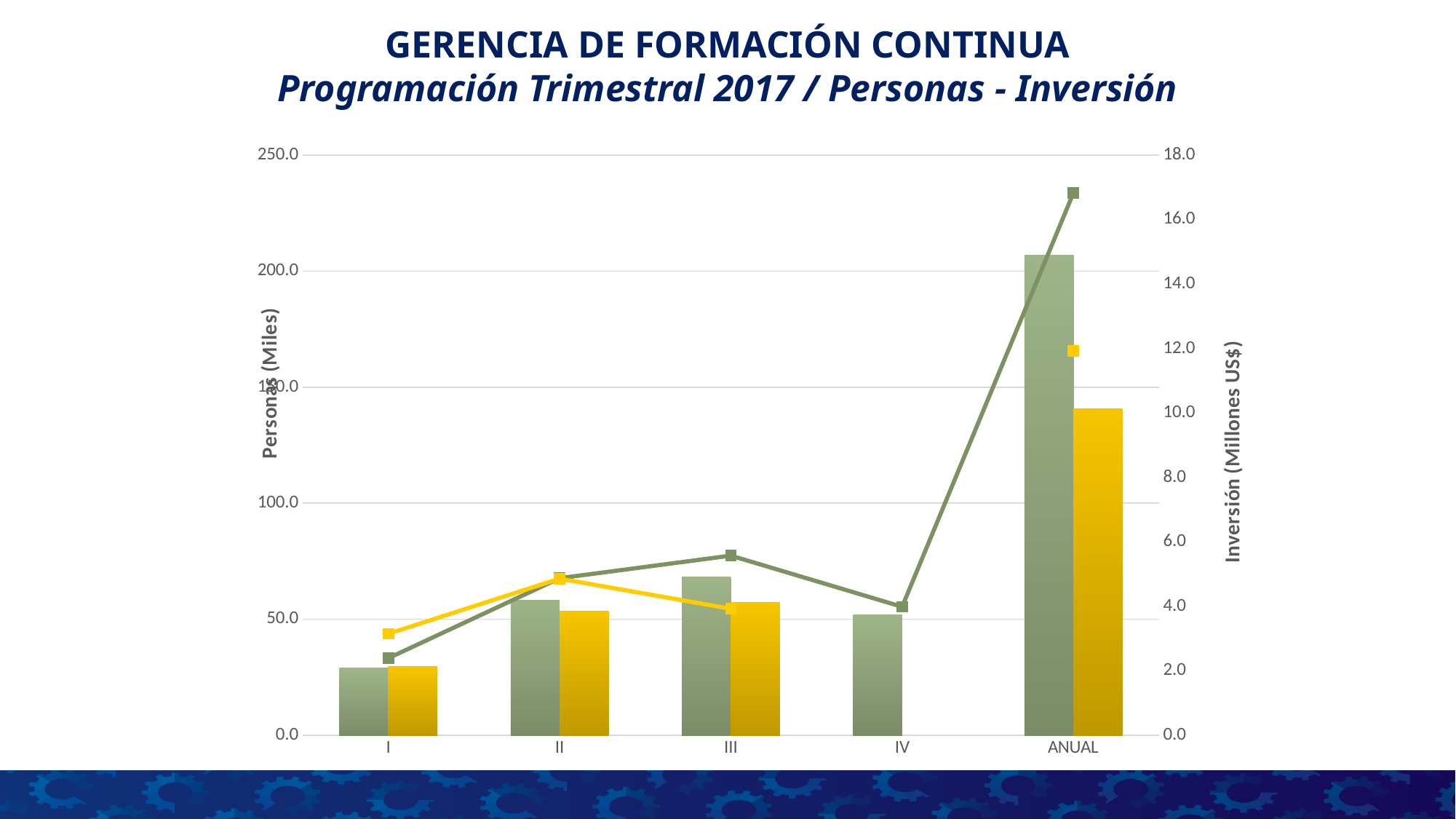
Which category has the tallest yellow bar? ANUAL What kind of chart is shown on the slide? Combined bar and line chart Does the yellow line rise or fall from II to III? Falls At category III, which bar is taller, the green bar or the yellow bar? Green bar How many categories are shown on the x axis? 5 Does the green line rise or fall from IV to ANUAL? Rises At category I, which line point is higher, the green line or the yellow line? Yellow line Which category has the shortest green bar? I Read against the left axis, is the green bar for ANUAL greater or less than 200.0? greater What is the title of the right vertical axis? Inversión (Millones US$) Which category has no yellow bar? IV Which category has the tallest green bar? ANUAL